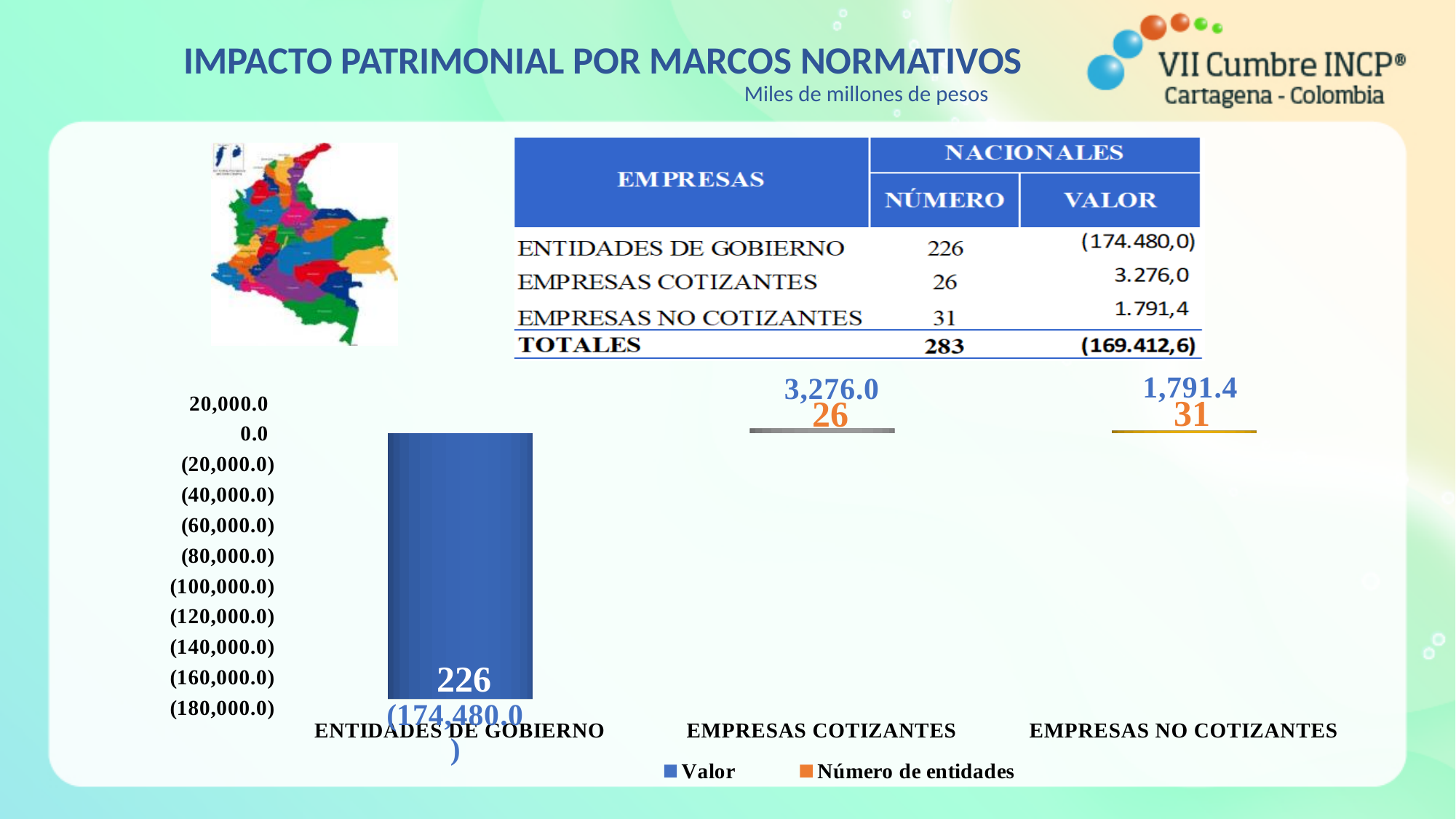
Which category has the highest Número de entidades in the chart? ENTIDADES DE GOBIERNO What is the Número de entidades value for ENTIDADES DE GOBIERNO in the chart? 226 What is the Valor data label for EMPRESAS COTIZANTES in the chart? 3,276.0 How many series does the chart legend list? 2 What kind of chart is shown on the slide? bar chart Which category has the lowest Número de entidades in the chart? EMPRESAS COTIZANTES How many categories are shown on the x axis of the chart? 3 Which has the larger Valor in the chart, EMPRESAS COTIZANTES or EMPRESAS NO COTIZANTES? EMPRESAS COTIZANTES What is the Número de entidades value for EMPRESAS NO COTIZANTES in the chart? 31 What are the two series names listed in the chart legend? Valor and Número de entidades What is the Valor data label for EMPRESAS NO COTIZANTES in the chart? 1,791.4 What is the Valor data label for ENTIDADES DE GOBIERNO in the chart? (174,480.0)